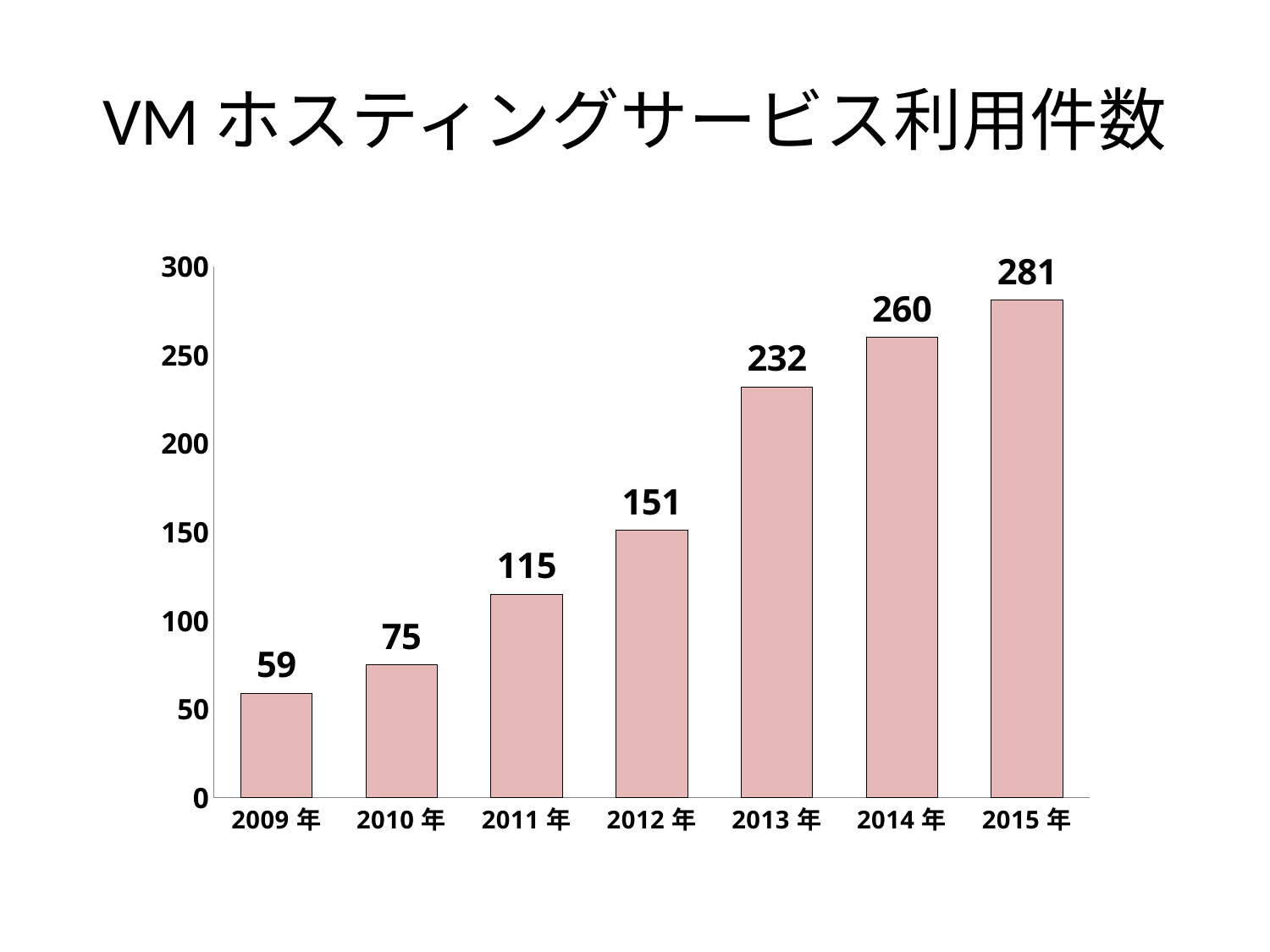
What is the difference between the values for 2013 年 and 2012 年? 81 Is the value for 2013 年 greater or less than 200? greater Do the values rise or fall from 2009 年 to 2015 年? rise Which is larger, the value for 2011 年 or the value for 2010 年? 2011 年 What kind of chart is shown on the slide? bar chart What is the difference between the values for 2015 年 and 2009 年? 222 Which year has the highest value? 2015 年 What is the value for 2009 年? 59 What is the value for 2014 年? 260 Which year has the lowest value? 2009 年 What is the value for 2012 年? 151 How many years are shown on the x axis? 7